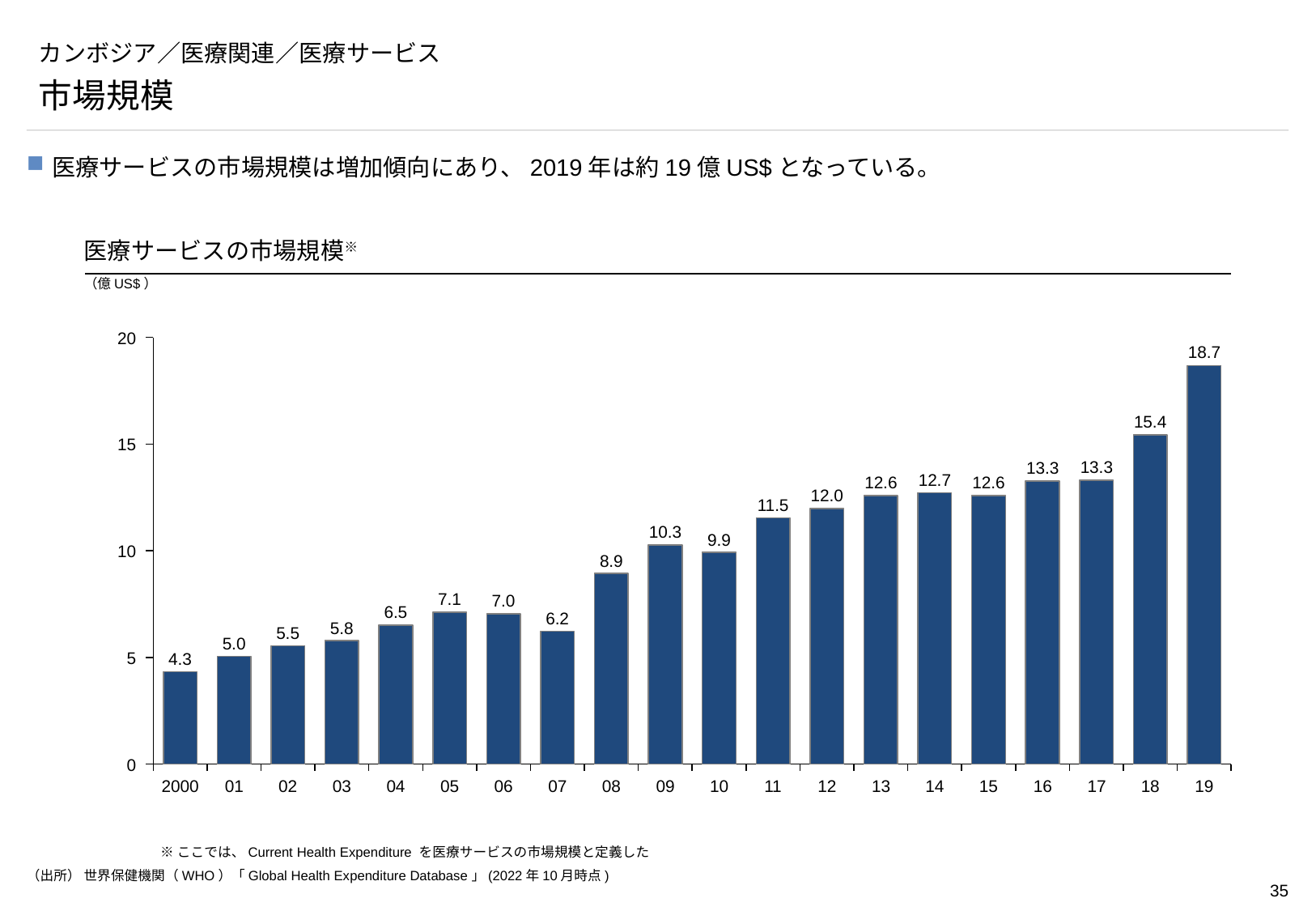
Do the values generally rise or fall from 2000 to 2019? rise Which year has the highest value in the chart? 19 What is the value for 2000 in the chart? 4.3 How many years are shown on the x axis of the chart? 20 What is the value for 2019 in the chart? 18.7 What kind of chart is shown on the slide? bar chart What unit is shown for the values in the chart? 億US$ What is the difference between the values for 2019 and 2018? 3.3 Is the value for 2011 greater or less than 10? greater What is the value for 2010 in the chart? 9.9 Which year has the lowest value in the chart? 2000 Which is larger, the value for 2009 or the value for 2010? 2009